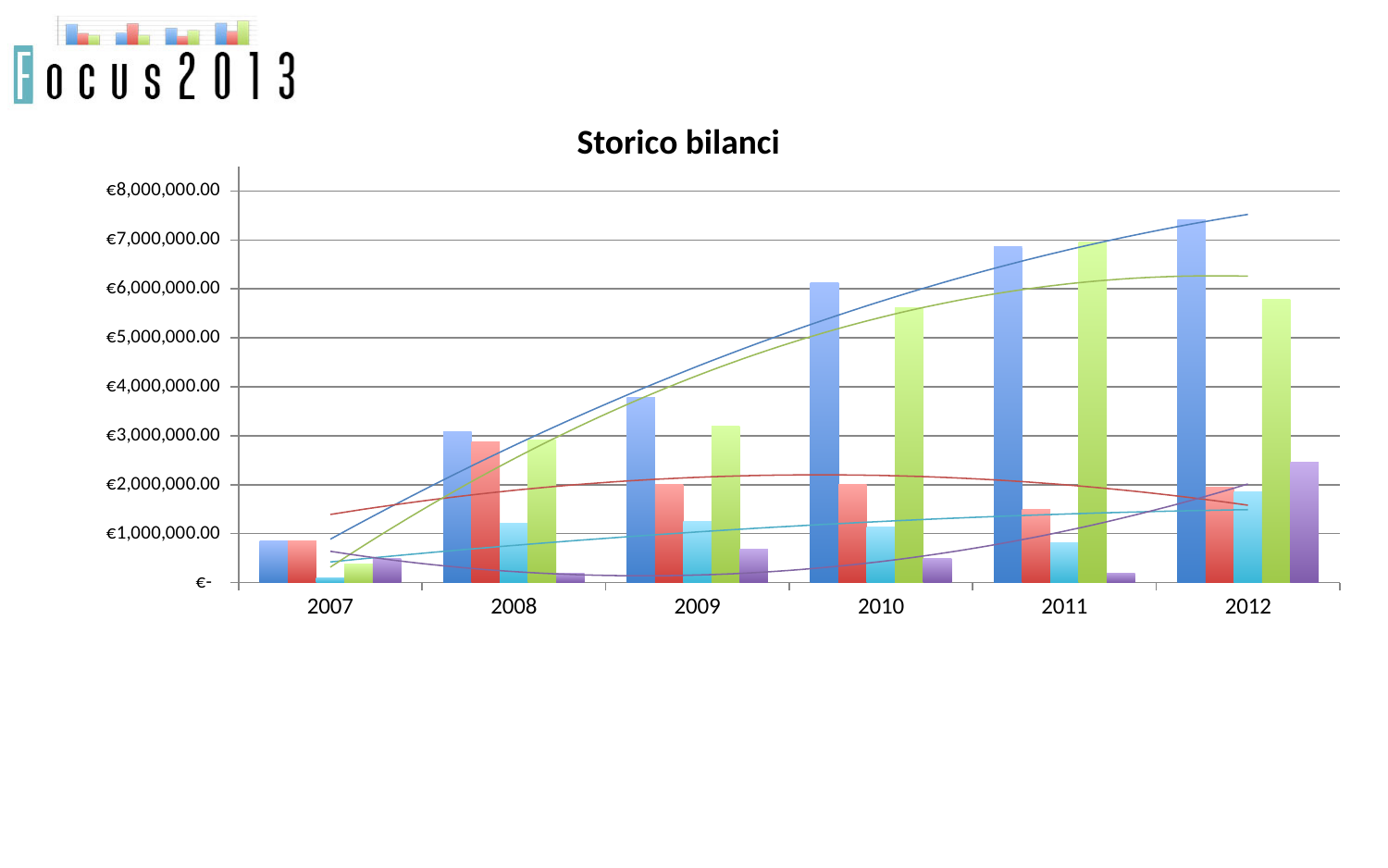
Do the blue bars rise or fall from 2007 to 2012? rise What is the highest value shown on the vertical axis of the chart? €8,000,000.00 Is the blue bar for 2007 greater or less than €1,000,000.00? less What kind of chart is shown on the slide? bar chart Is the blue bar for 2012 greater or less than €7,000,000.00? greater Which is taller in 2012, the blue bar or the green bar? the blue bar Is the green bar for 2012 greater or less than €6,000,000.00? less What is the title of the chart? Storico bilanci In which year is the blue bar the tallest? 2012 In which year is the blue bar the shortest? 2007 How many years are shown on the x axis of the chart? 6 In which year is the green bar the tallest? 2011